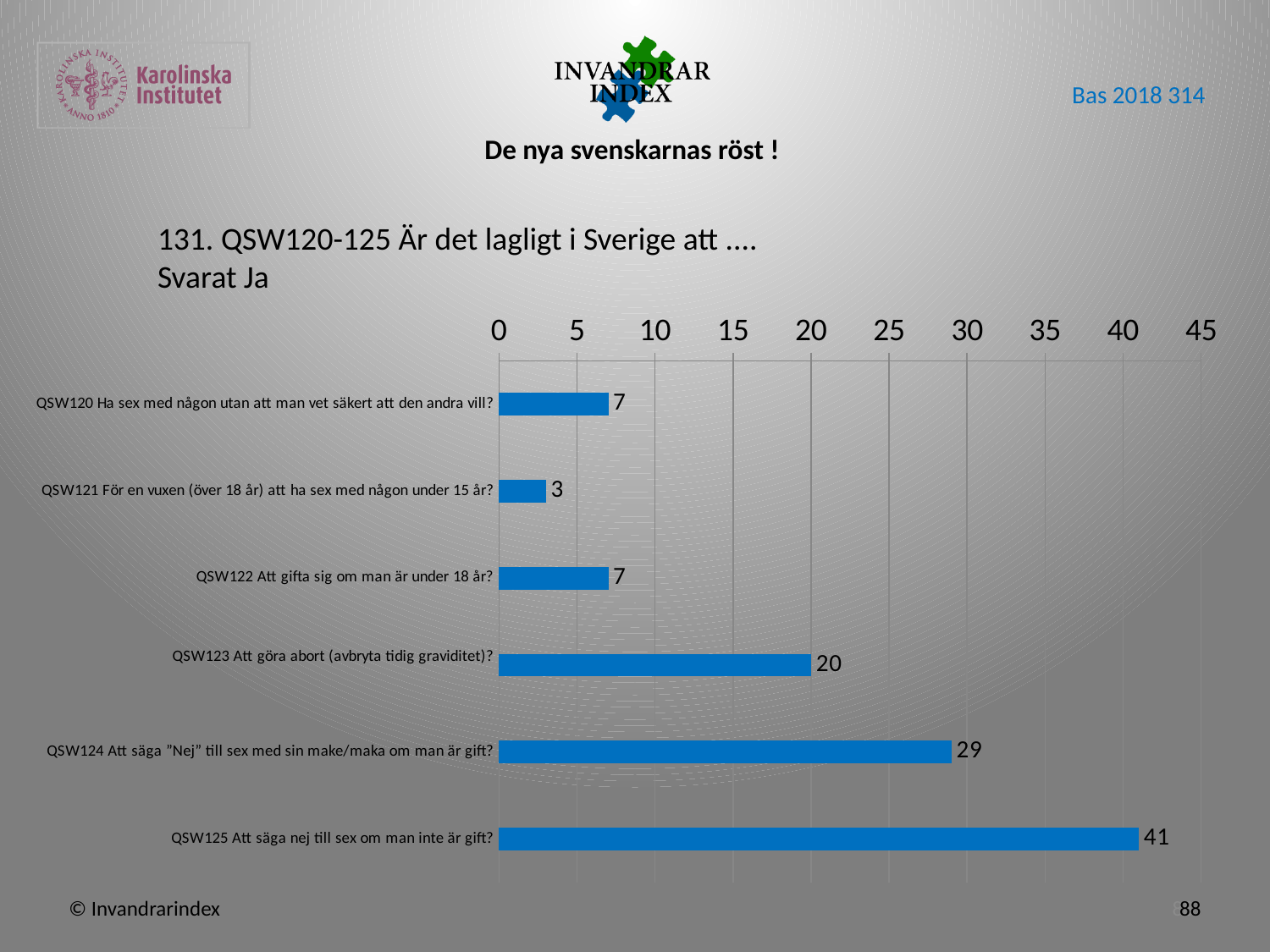
What is the value for QSW124 Att säga "Nej" till sex med sin make/maka om man är gift? 29 What is the maximum value shown on the chart's axis? 45 What kind of chart is shown on the slide? bar chart What is the value for QSW123 Att göra abort (avbryta tidig graviditet)? 20 Which is larger, the value for QSW123 or the value for QSW124? QSW124 Is the value for QSW123 Att göra abort greater or less than 25? less What is the value for QSW125 Att säga nej till sex om man inte är gift? 41 What is the difference between the values for QSW125 and QSW124? 12 How many categories are shown in the chart? 6 Which category has the highest value? QSW125 Att säga nej till sex om man inte är gift? Which category has the lowest value? QSW121 För en vuxen (över 18 år) att ha sex med någon under 15 år? What is the value for QSW121 För en vuxen (över 18 år) att ha sex med någon under 15 år? 3